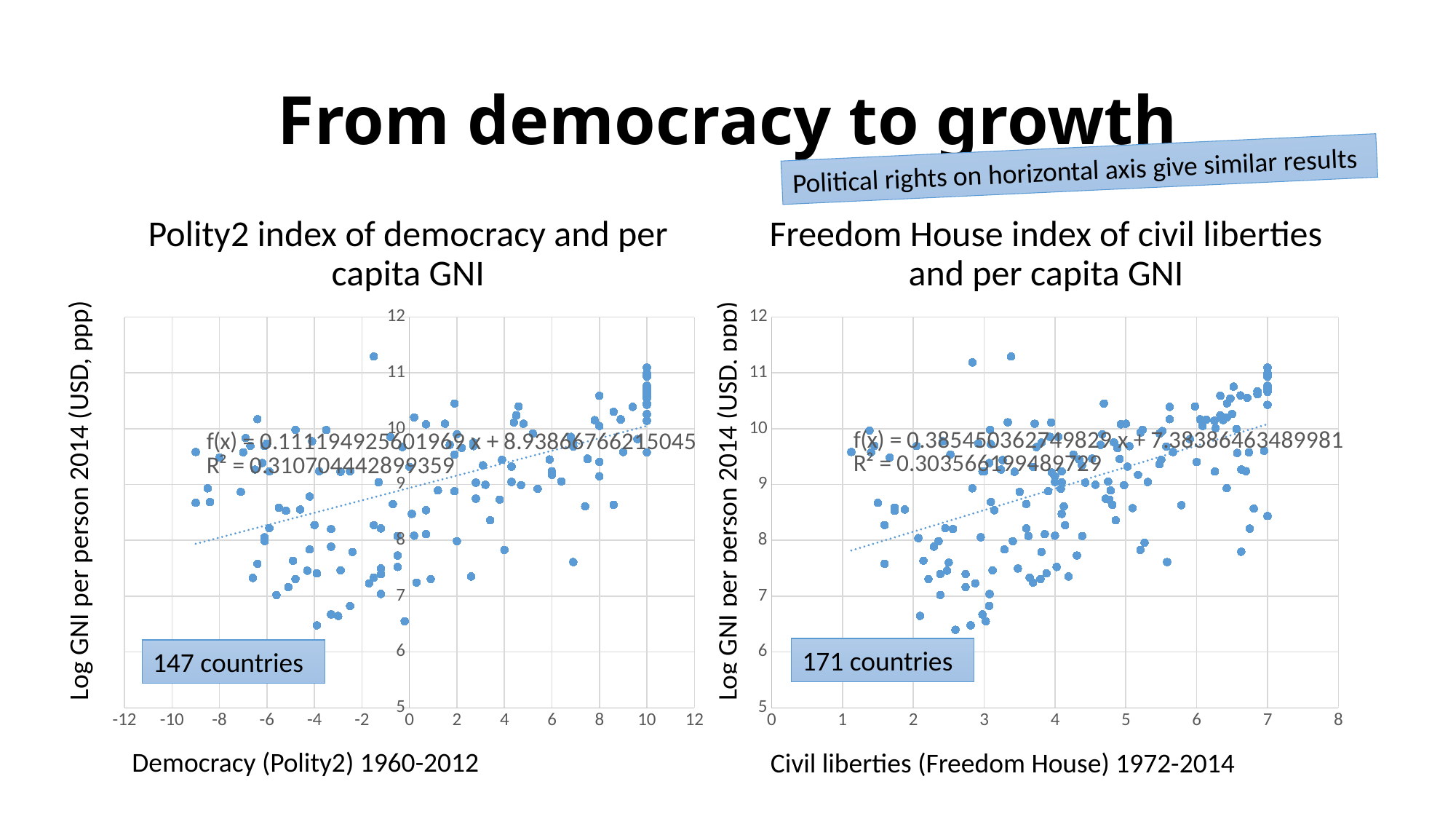
Which chart has the higher R² value, the left (Polity2) chart or the right (Freedom House) chart? Left (Polity2) chart What kind of chart is the left chart, 'Polity2 index of democracy and per capita GNI'? Scatter plot What is the R² value shown on the left chart (Polity2)? 0.310704442899359 What is the y-axis label of the left chart (Polity2)? Log GNI per person 2014 (USD, ppp) In the left chart (Polity2), does the fitted trend line rise or fall as the democracy score increases? Rises What is the trend line equation shown on the right chart (Freedom House)? f(x) = 0.385450362749829 x + 7.38386463489981 How many countries are plotted in the left chart (Polity2 index of democracy and per capita GNI)? 147 countries What is the R² value shown on the right chart (Freedom House)? 0.303566199489729 What kind of chart is the right chart, 'Freedom House index of civil liberties and per capita GNI'? Scatter plot What is the x-axis label of the right chart (Freedom House)? Civil liberties (Freedom House) 1972-2014 How many countries are plotted in the right chart (Freedom House index of civil liberties and per capita GNI)? 171 countries In the right chart (Freedom House), does the fitted trend line rise or fall as civil liberties increase? Rises